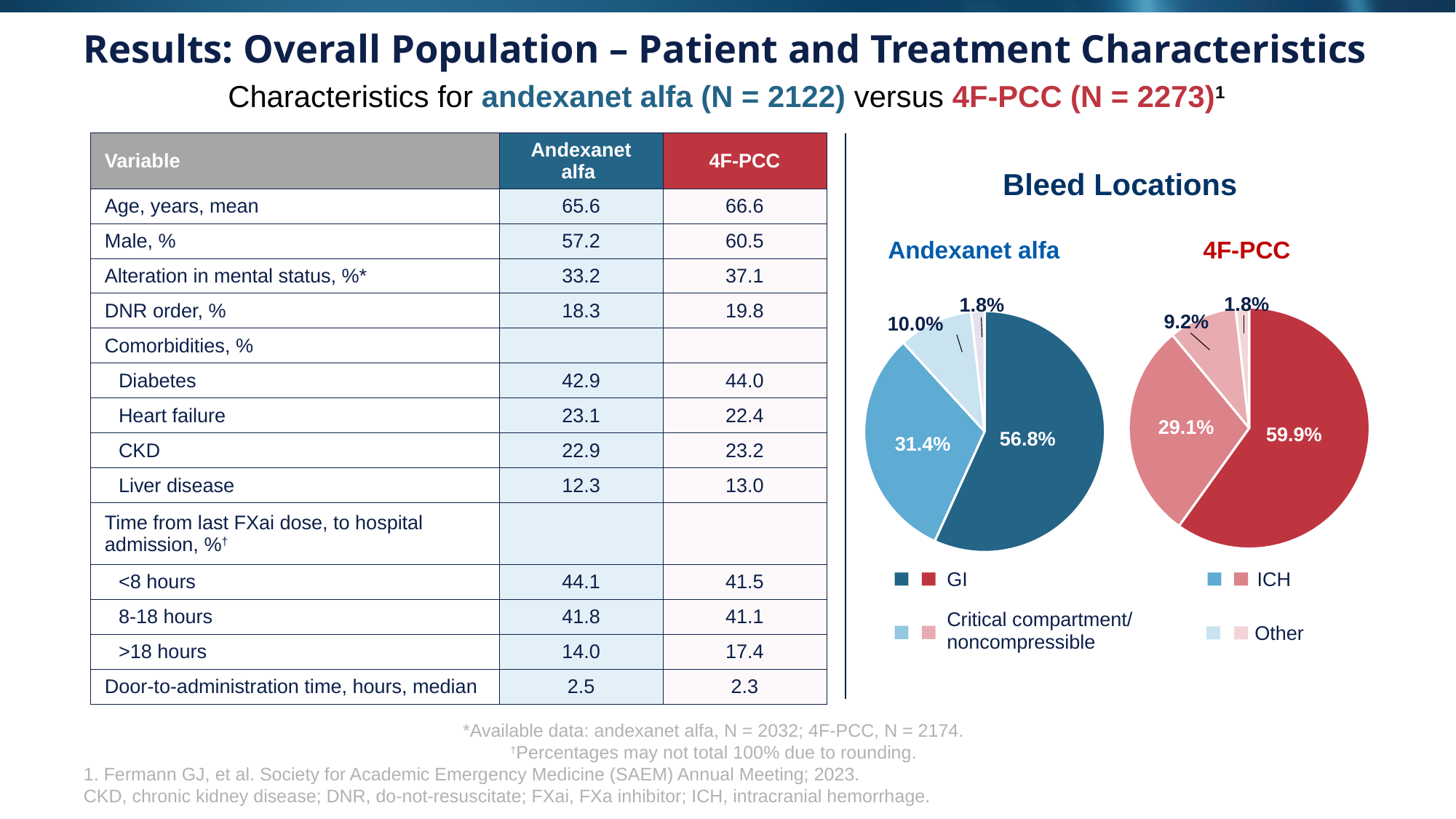
In the 4F-PCC pie chart, what share of bleed locations is ICH? 29.1% In the Andexanet alfa pie chart, what is the difference between the GI share and the ICH share? 25.4% In the Andexanet alfa pie chart, which bleed location has the smallest share? Other What is the title above the two pie charts on the slide? Bleed Locations In the 4F-PCC pie chart, which bleed location has the largest share? GI In the Andexanet alfa pie chart, what share of bleed locations is GI? 56.8% Which pie chart shows a larger ICH share, Andexanet alfa or 4F-PCC? Andexanet alfa How many bleed location categories does the legend of the Bleed Locations charts list? 4 In the Andexanet alfa pie chart, what percentage is shown for Critical compartment/noncompressible bleeds? 10.0% What is the difference between the GI share in the 4F-PCC pie chart and the GI share in the Andexanet alfa pie chart? 3.1% What kind of charts are used to show Bleed Locations on the slide? Pie charts In the 4F-PCC pie chart, what percentage is shown for Other bleed locations? 1.8%